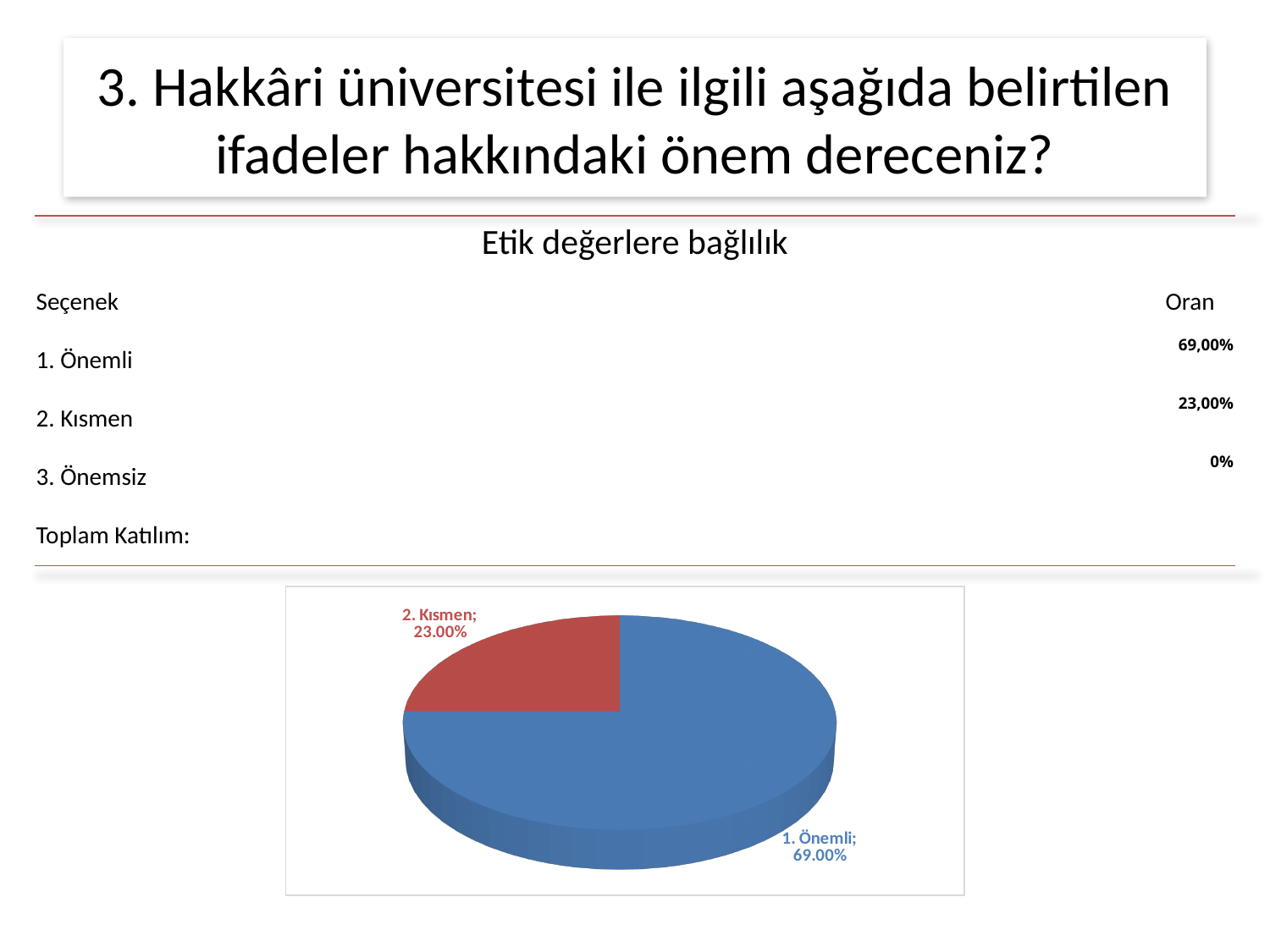
Is the value for "2. Kısmen" in the pie chart greater or less than 50%? less Which is larger in the pie chart, "1. Önemli" or "2. Kısmen"? 1. Önemli What is the difference between the values for "1. Önemli" and "2. Kısmen" in the pie chart? 46.00% Which slice of the pie chart is the largest? 1. Önemli How many labelled slices does the pie chart have? 2 What colour is the "2. Kısmen" slice in the pie chart? red What is the value shown for the slice labelled "1. Önemli" in the pie chart? 69.00% What is the value shown for the slice labelled "2. Kısmen" in the pie chart? 23.00% Is the value for "1. Önemli" in the pie chart greater or less than 50%? greater What kind of chart is shown at the bottom of the slide? pie chart What colour is the "1. Önemli" slice in the pie chart? blue Which labelled slice of the pie chart is the smallest? 2. Kısmen